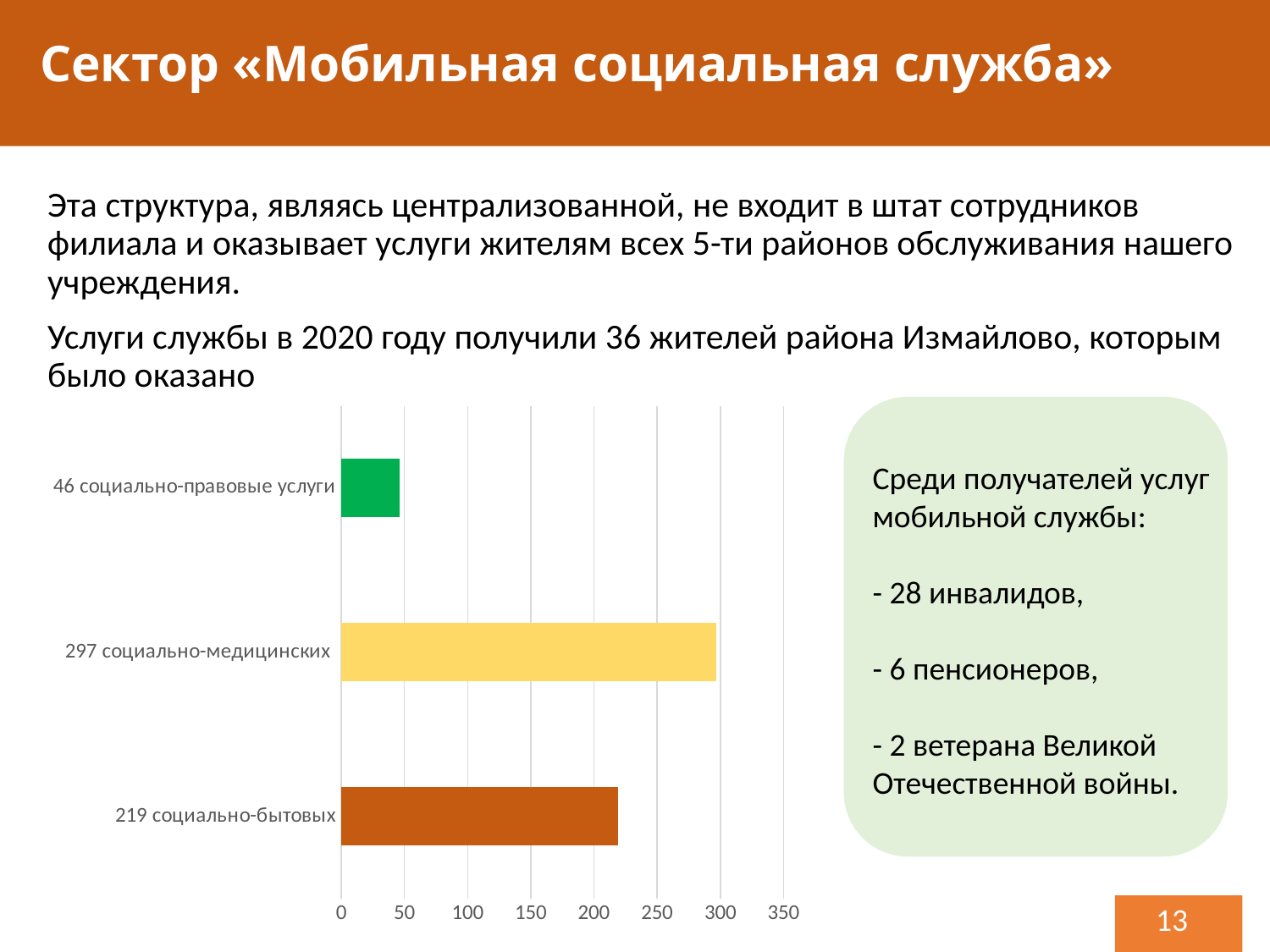
How many categories (bars) does the chart show? 3 How many социально-медицинских services are shown in the chart? 297 Which is larger: социально-бытовых or социально-правовые услуги? социально-бытовых What is the difference between the социально-бытовых and социально-правовые услуги values? 173 Which category has the highest value in the chart? социально-медицинских What colour is the bar for социально-медицинских? yellow Which category has the lowest value in the chart? социально-правовые услуги How many социально-правовые услуги are shown in the chart? 46 How many социально-бытовых services are shown in the chart? 219 What kind of chart is shown on the slide? bar chart Is the value for социально-бытовых greater or less than 200? greater What is the difference between the социально-медицинских and социально-бытовых values? 78